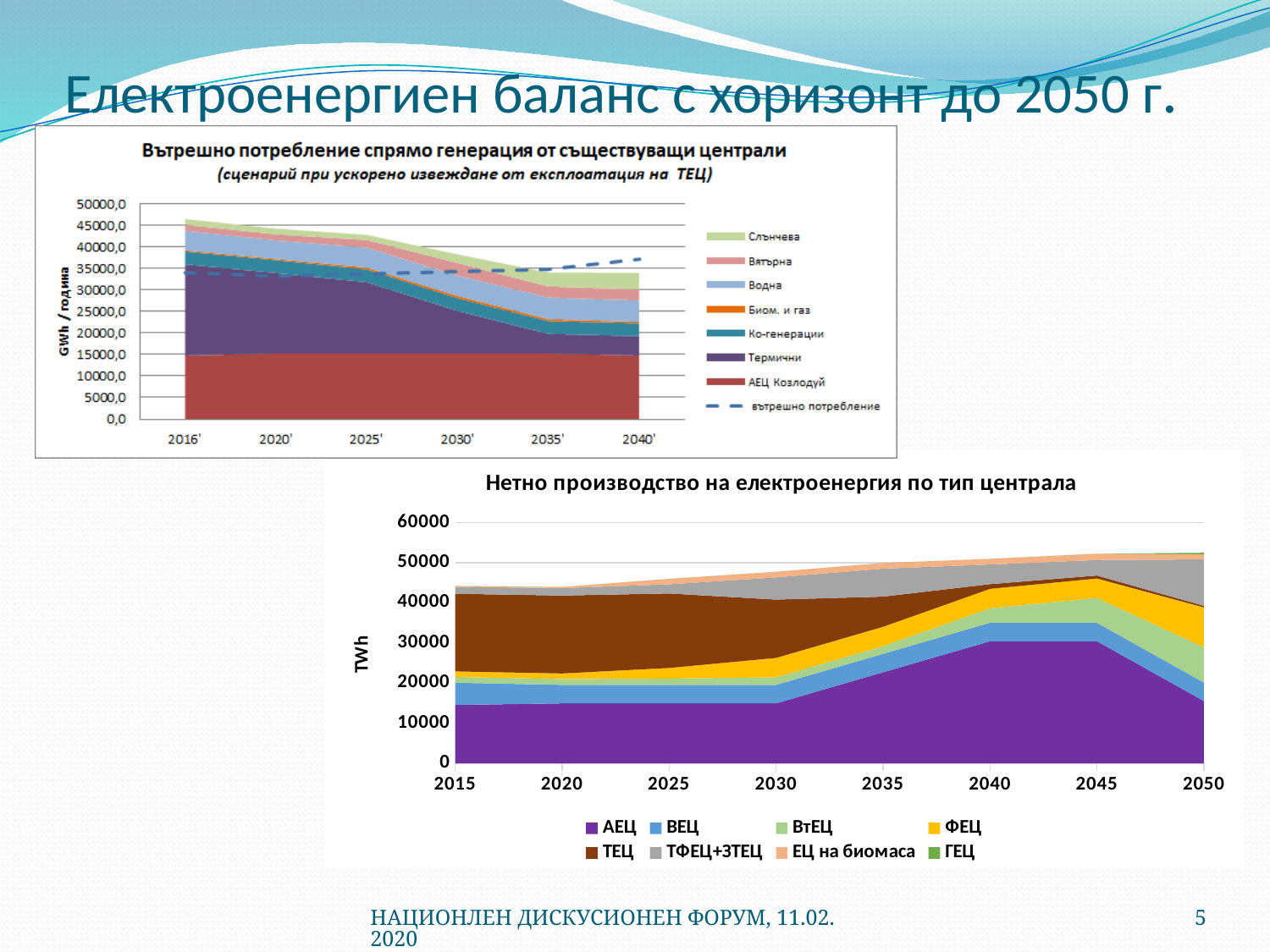
In the top chart, is the total stacked generation in 2040' greater or less than 40000,0? less In the top chart, does the total stacked generation rise or fall from 2016' to 2040'? fall What type of chart is the bottom chart titled 'Нетно производство на електроенергия по тип централа'? Stacked area chart How many entries does the legend of the bottom chart list? 8 What type of chart is the top chart titled 'Вътрешно потребление спрямо генерация от съществуващи централи'? Stacked area chart In the bottom chart, is the value for АЕЦ in 2040 greater or less than 20000? greater How many entries does the legend of the top chart list? 8 In the top chart, which series is drawn as a dashed line? вътрешно потребление In the top chart, how many years are shown on the x axis? 6 In the bottom chart, is the value for АЕЦ in 2015 greater or less than 20000? less In the bottom chart, how many years are shown on the x axis? 8